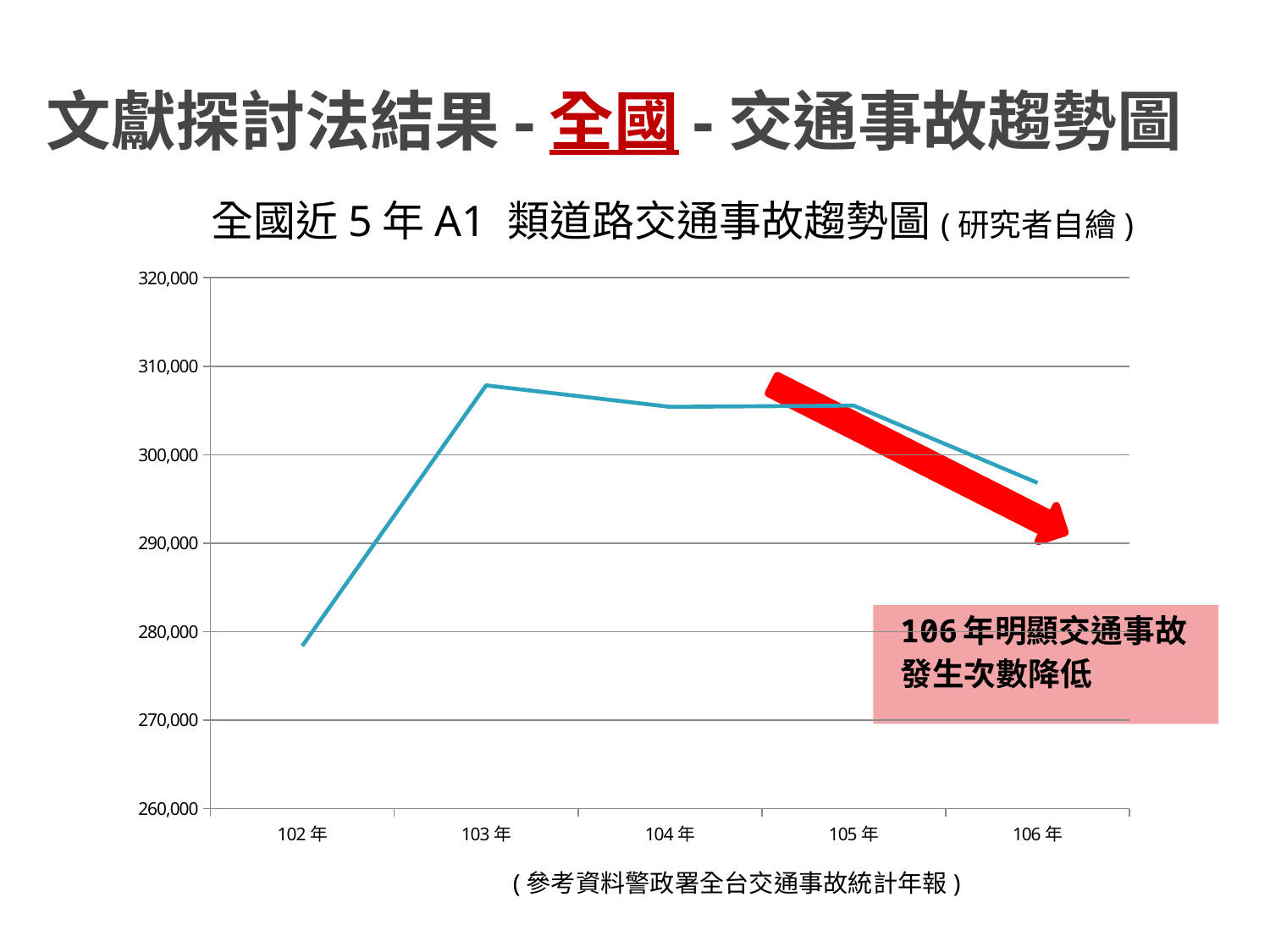
Is the value for 103 年 greater or less than 300,000? greater What kind of chart is shown on the slide? line chart Which year has the lowest number of A1 traffic accidents? 102 年 Is the value for 105 年 greater or less than 310,000? less What is the title of the chart? 全國近 5 年 A1 類道路交通事故趨勢圖 ( 研究者自繪 ) Which is larger, the value for 102 年 or the value for 106 年? 106 年 Is the value for 102 年 greater or less than 280,000? less Which year has the highest number of A1 traffic accidents? 103 年 Does the line rise or fall from 105 年 to 106 年? fall Does the line rise or fall from 102 年 to 103 年? rise How many years (data points) are plotted on the x axis? 5